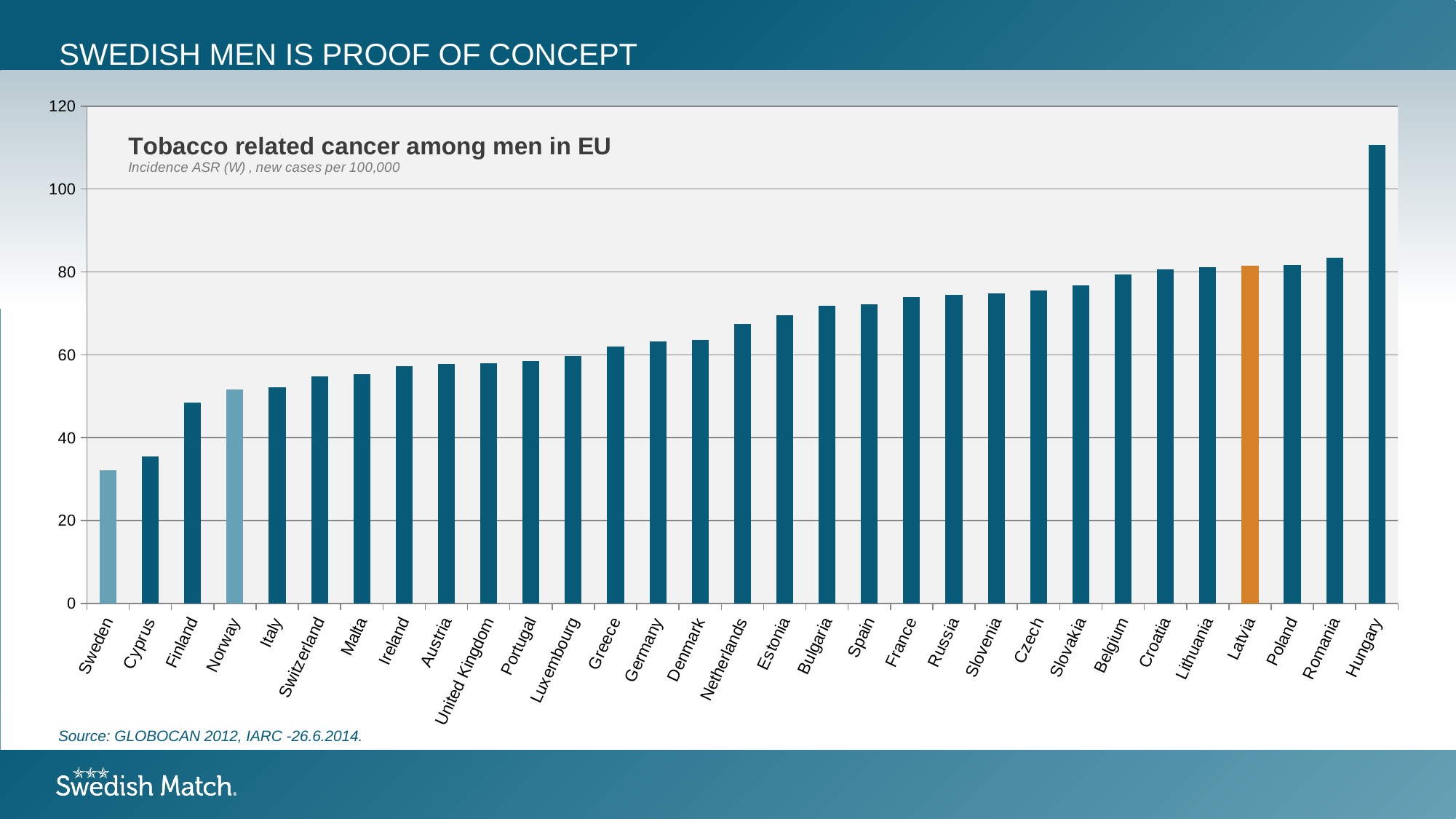
Is the value for Sweden greater or less than 40? less Do the values generally rise or fall from left to right across the countries? rise What kind of chart is shown on the slide? bar chart How many countries are shown in the chart? 31 Which country has the highest tobacco related cancer incidence among men in the chart? Hungary Which has a higher value, Finland or Norway? Norway Which country has the lowest tobacco related cancer incidence among men in the chart? Sweden Is the value for Romania greater or less than 80? greater Is the value for Netherlands greater or less than 60? greater What is the title of the chart? Tobacco related cancer among men in EU